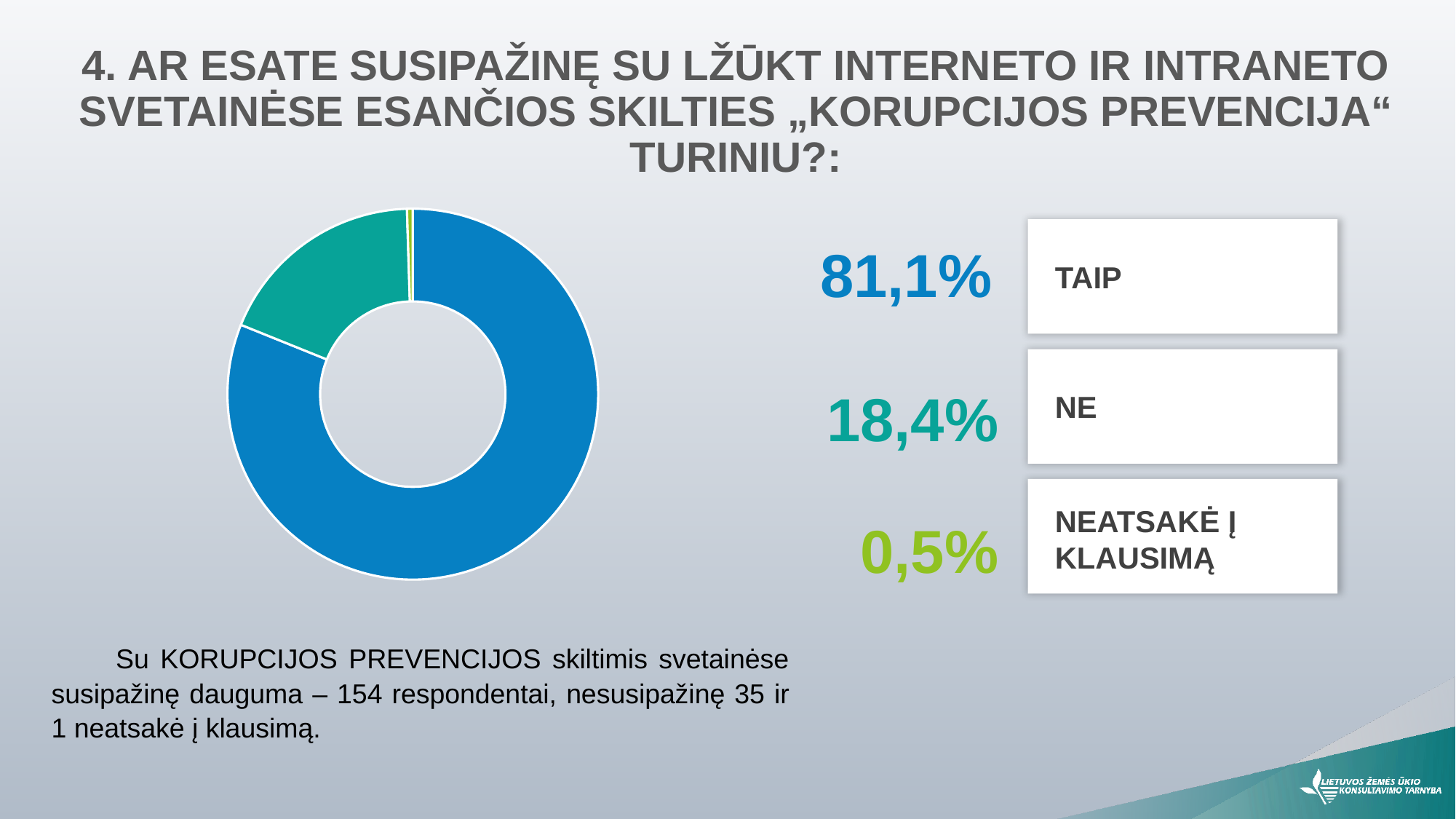
What share of respondents answered TAIP? 81,1% How many categories are shown in the donut chart? 3 What share of respondents did not answer the question (NEATSAKĖ Į KLAUSIMĄ)? 0,5% What type of chart is shown on the slide? Donut (pie) chart What colour is the slice representing NE? Teal (green-blue) Which answer has the smallest share of the donut chart? NEATSAKĖ Į KLAUSIMĄ Which answer has the largest share of the donut chart? TAIP What is the difference in percentage points between TAIP and NE? 62,7 What colour is the slice representing TAIP? Blue What is the difference in percentage points between NE and NEATSAKĖ Į KLAUSIMĄ? 17,9 Which is larger, the share for NE or the share for NEATSAKĖ Į KLAUSIMĄ? NE What share of respondents answered NE? 18,4%